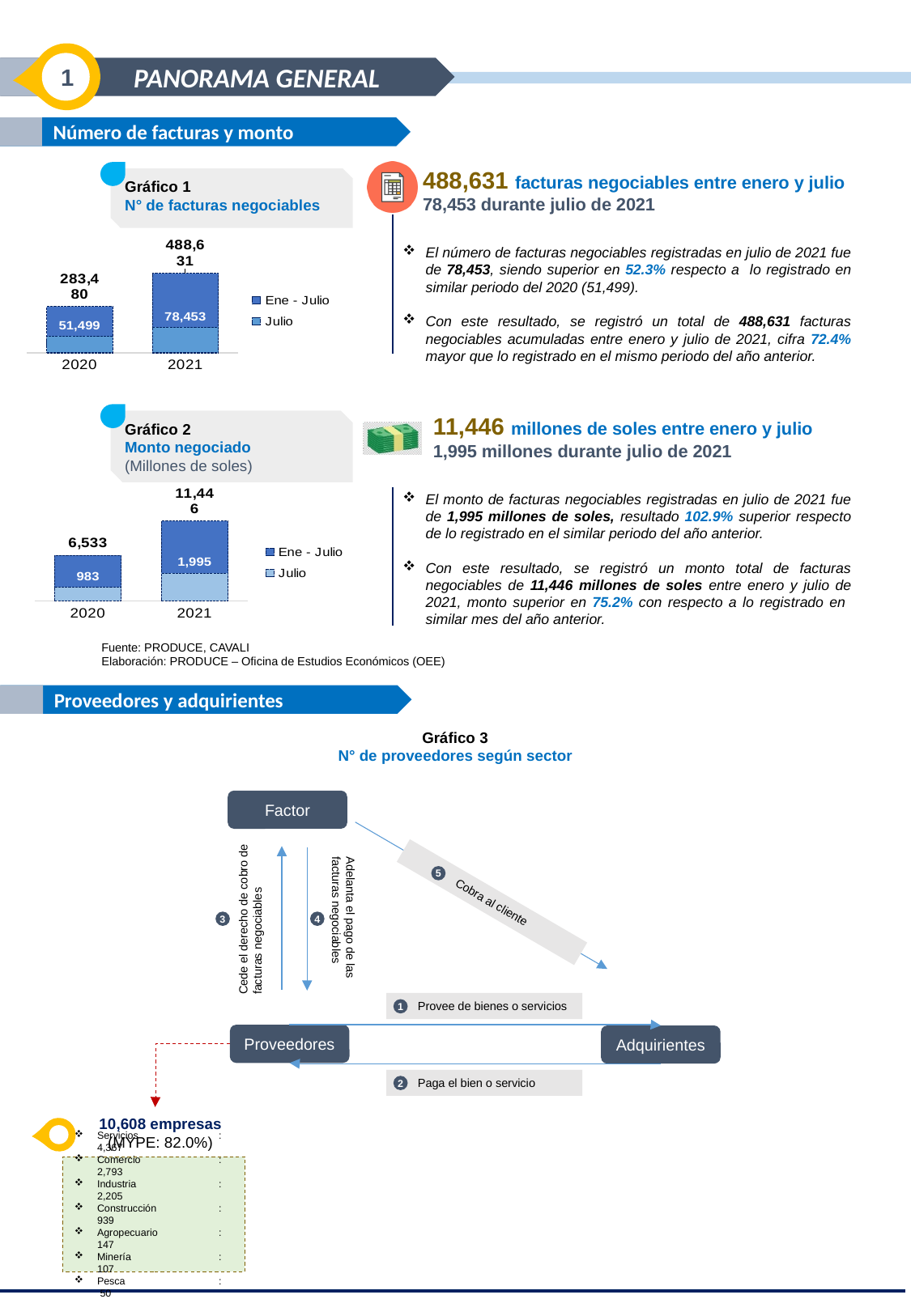
In Gráfico 1 (N° de facturas negociables), what is the value for Julio in 2020? 51,499 In Gráfico 2 (Monto negociado), what is the value for Julio in 2021? 1,995 In Gráfico 2 (Monto negociado), what unit is stated in the chart title? Millones de soles In Gráfico 2 (Monto negociado), what is the value for Ene - Julio in 2020? 6,533 In Gráfico 2 (Monto negociado), how many years are shown on the x axis? 2 In Gráfico 1 (N° de facturas negociables), how many series does the legend list? 2 In Gráfico 1 (N° de facturas negociables), what is the value for Ene - Julio in 2021? 488,631 What kind of chart is Gráfico 1 (N° de facturas negociables)? Bar chart In Gráfico 2 (Monto negociado), which year has the larger Julio value, 2020 or 2021? 2021 In Gráfico 1 (N° de facturas negociables), what is the value for Julio in 2021? 78,453 In Gráfico 1 (N° de facturas negociables), what is the difference between the Julio values for 2021 and 2020? 26,954 In Gráfico 2 (Monto negociado), what is the difference between the Ene - Julio values for 2021 and 2020? 4,913